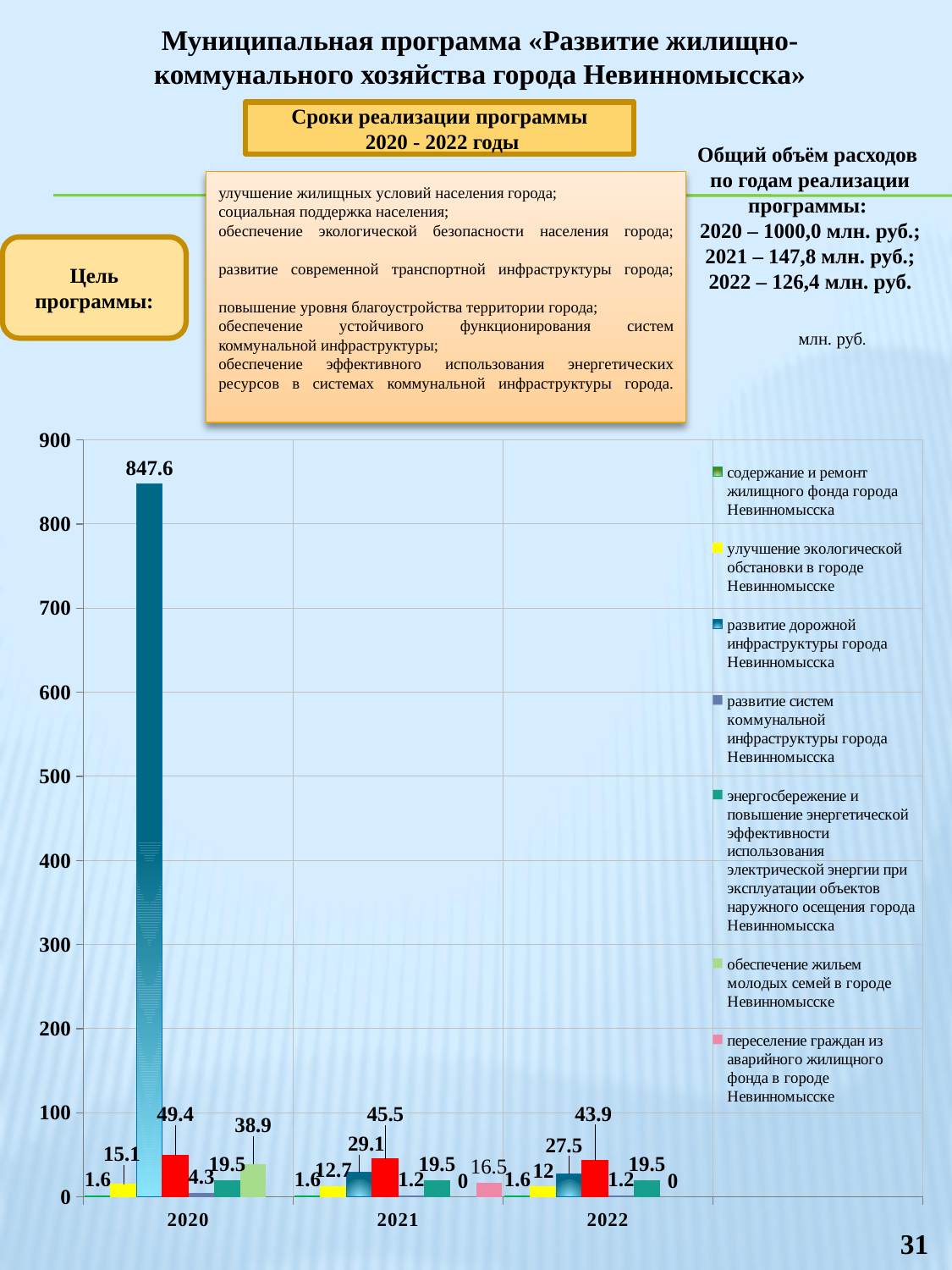
What is the value for «улучшение экологической обстановки в городе Невинномысске» in 2021? 12.7 What is the highest tick value shown on the y axis? 900 In which year is the value for «развитие дорожной инфраструктуры города Невинномысска» the highest? 2020 What is the value for «развитие дорожной инфраструктуры города Невинномысска» in 2020? 847.6 What is the value for «переселение граждан из аварийного жилищного фонда в городе Невинномысске» in 2021? 16.5 What is the value for «обеспечение жильем молодых семей в городе Невинномысске» in 2020? 38.9 Is the value for «развитие дорожной инфраструктуры города Невинномысска» in 2020 greater or less than 800? greater Which is larger: the value for «улучшение экологической обстановки в городе Невинномысске» in 2020 or in 2022? 2020 What kind of chart is shown on the slide? bar chart What is the difference between the values for «развитие дорожной инфраструктуры города Невинномысска» in 2021 and 2022? 1.6 How many year categories are shown on the x axis? 3 How many series does the legend list? 7